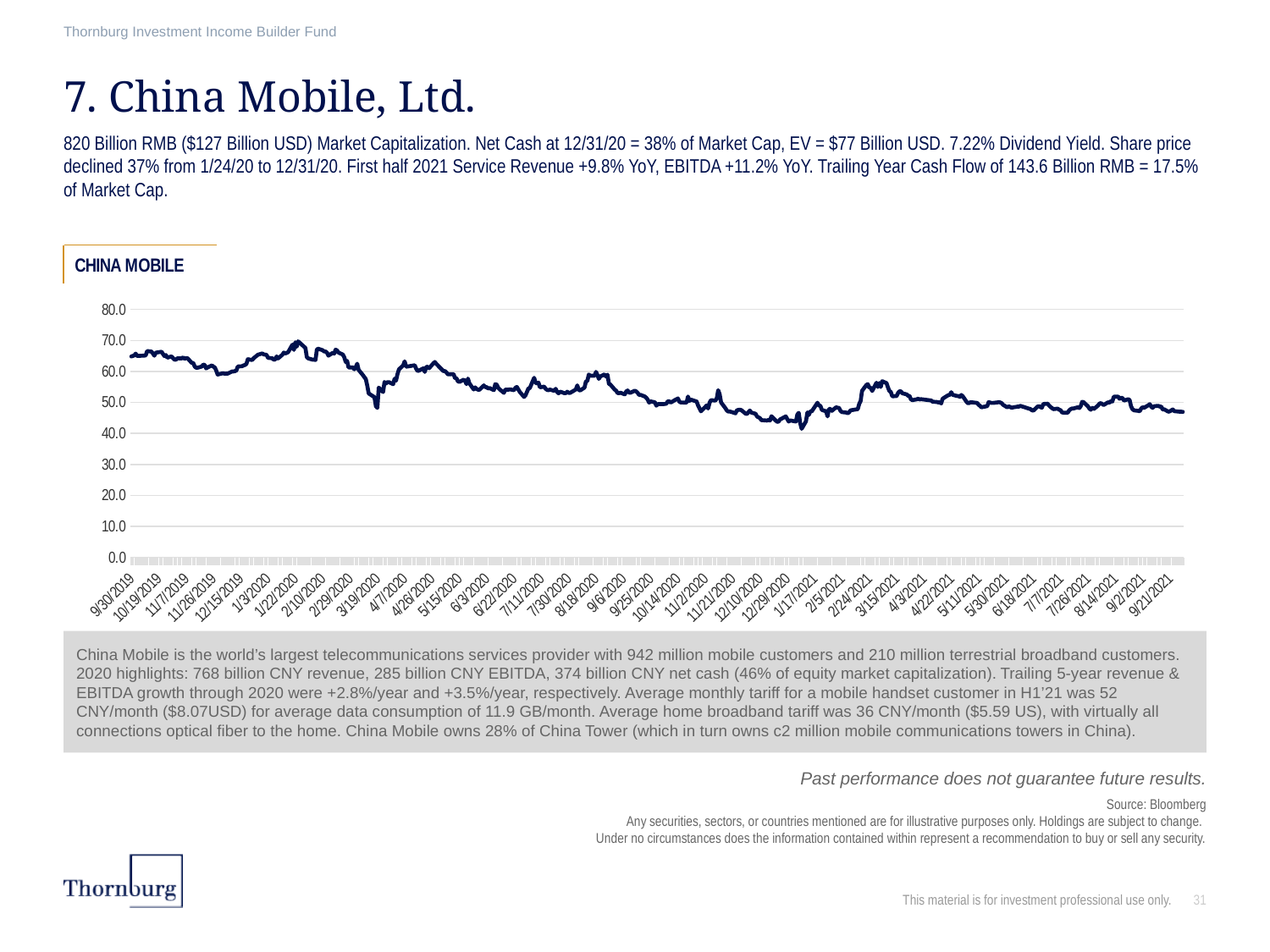
Is the value at 1/22/2020 greater or less than 60.0? greater What type of chart is shown on the slide? line chart What is the title of the chart? CHINA MOBILE What is the first date shown on the x axis of the chart? 9/30/2019 Is the value at 4/26/2020 greater or less than 50.0? greater Which is larger, the value at 9/30/2019 or the value at 9/21/2021? 9/30/2019 Is the value at 9/21/2021 greater or less than 50.0? less What is the highest value labelled on the vertical axis of the chart? 80.0 Overall, do the values rise or fall from the left of the x axis to the right? fall What is the last date shown on the x axis of the chart? 9/21/2021